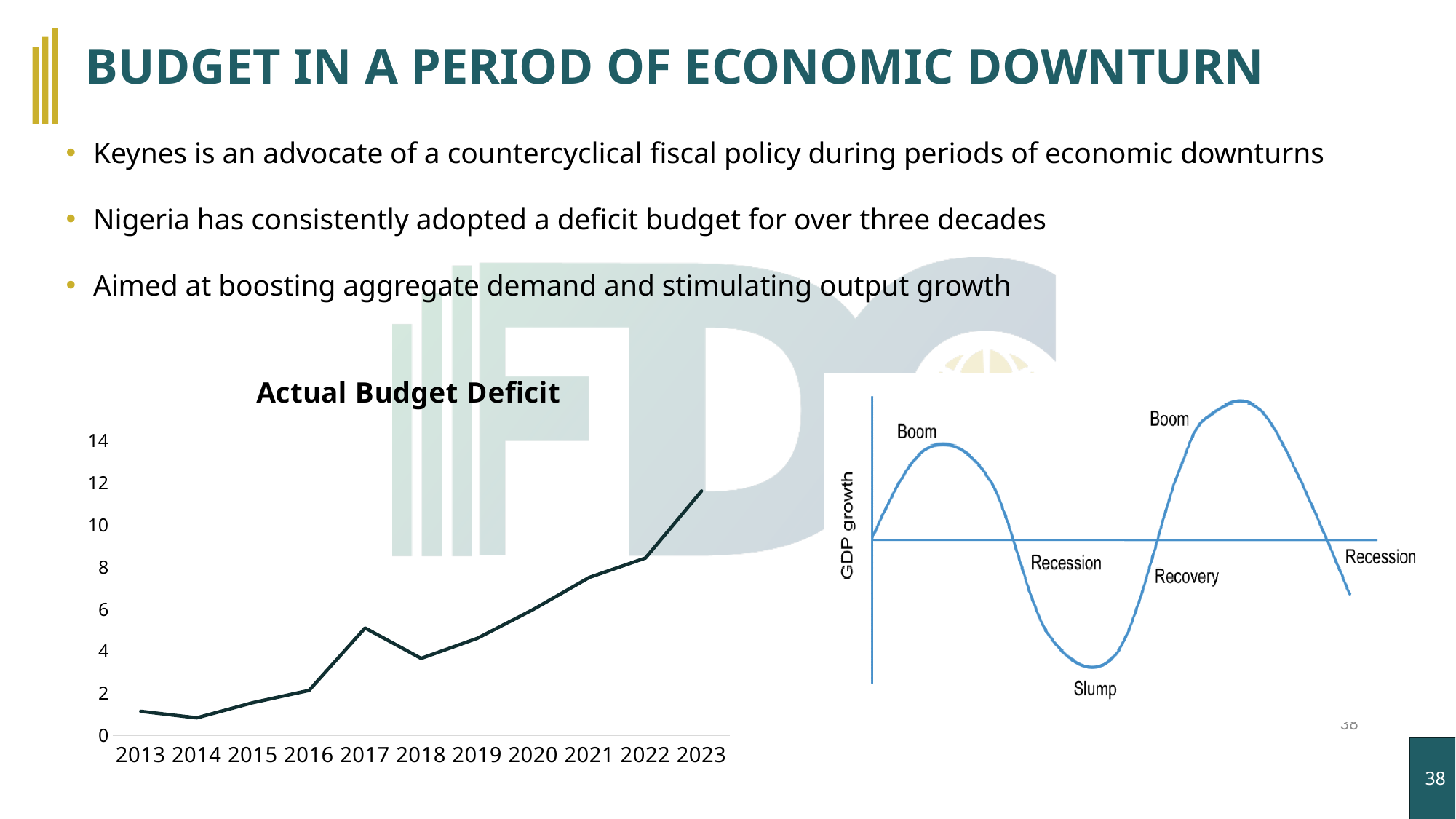
In the "Actual Budget Deficit" chart, which year has the lowest value? 2014 In the "Actual Budget Deficit" chart, is the value for 2021 greater or less than 8? less In the "Actual Budget Deficit" chart, is the value for 2023 greater or less than 10? greater In the "Actual Budget Deficit" chart, which year has the larger value, 2017 or 2018? 2017 In the "Actual Budget Deficit" chart, do values generally rise or fall from 2013 to 2023? rise In the "Actual Budget Deficit" chart, which year has the highest value? 2023 What is the title of the line chart on the left of the slide? Actual Budget Deficit What kind of chart is the "Actual Budget Deficit" chart? line chart In the "Actual Budget Deficit" chart, is the value for 2014 greater or less than 2? less How many years are shown on the x axis of the "Actual Budget Deficit" chart? 11 What is the highest tick value shown on the y axis of the "Actual Budget Deficit" chart? 14